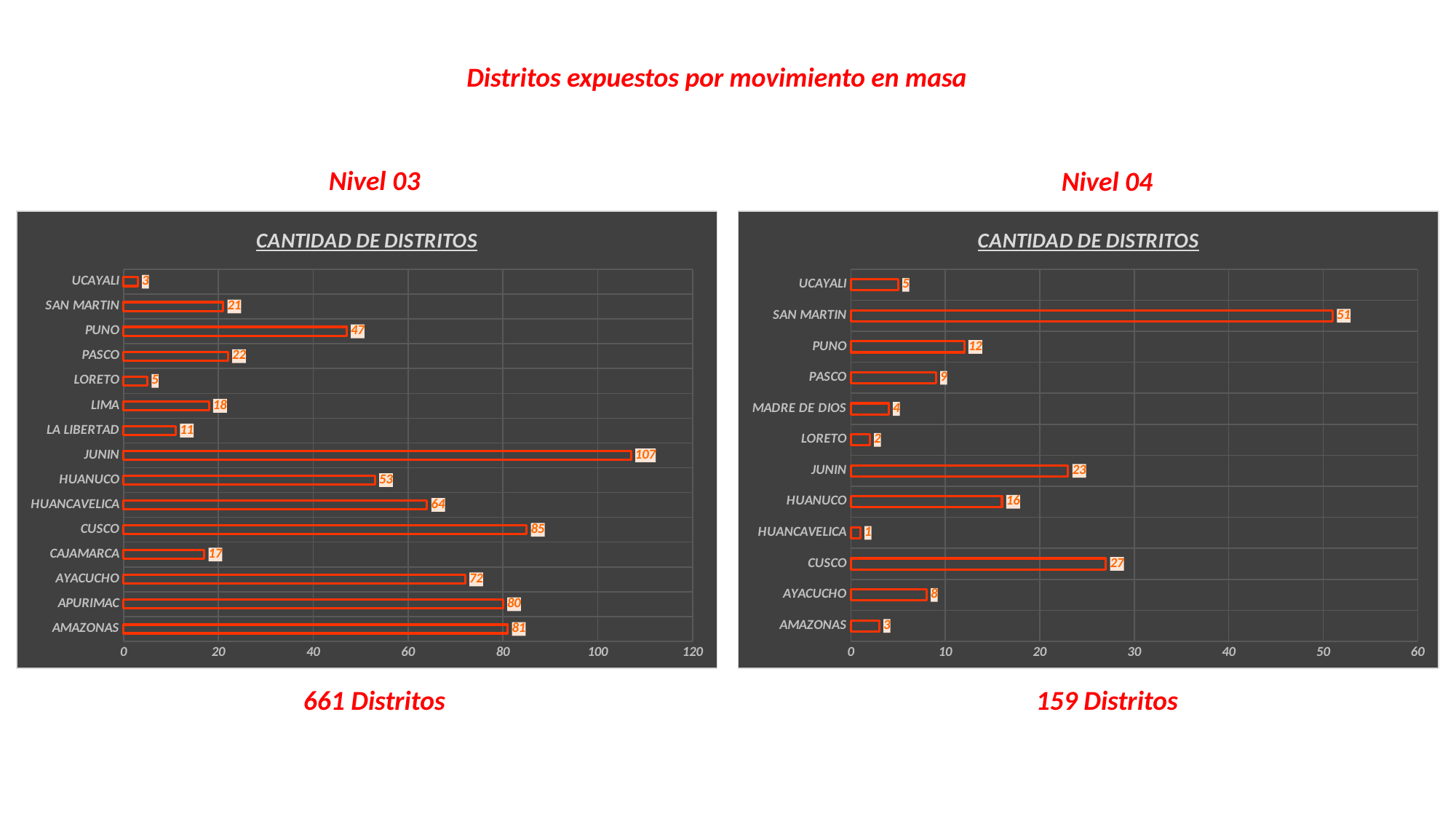
In the Nivel 04 chart, what is the difference between the values for PUNO and PASCO? 3 In the Nivel 03 chart, what is the value for JUNIN? 107 In the Nivel 03 chart, what is the difference between the values for CUSCO and AYACUCHO? 13 In the Nivel 04 chart, how many categories are shown? 12 In the Nivel 04 chart, which category has the lowest value? HUANCAVELICA In the Nivel 03 chart, which category has the lowest value? UCAYALI In the Nivel 03 chart, how many categories are shown? 15 What kind of chart is the Nivel 04 chart? bar chart What is the title shown inside the Nivel 03 chart? CANTIDAD DE DISTRITOS In the Nivel 04 chart, which is larger, the value for CUSCO or the value for JUNIN? CUSCO In the Nivel 03 chart, which category has the highest value? JUNIN In the Nivel 04 chart, what is the value for SAN MARTIN? 51